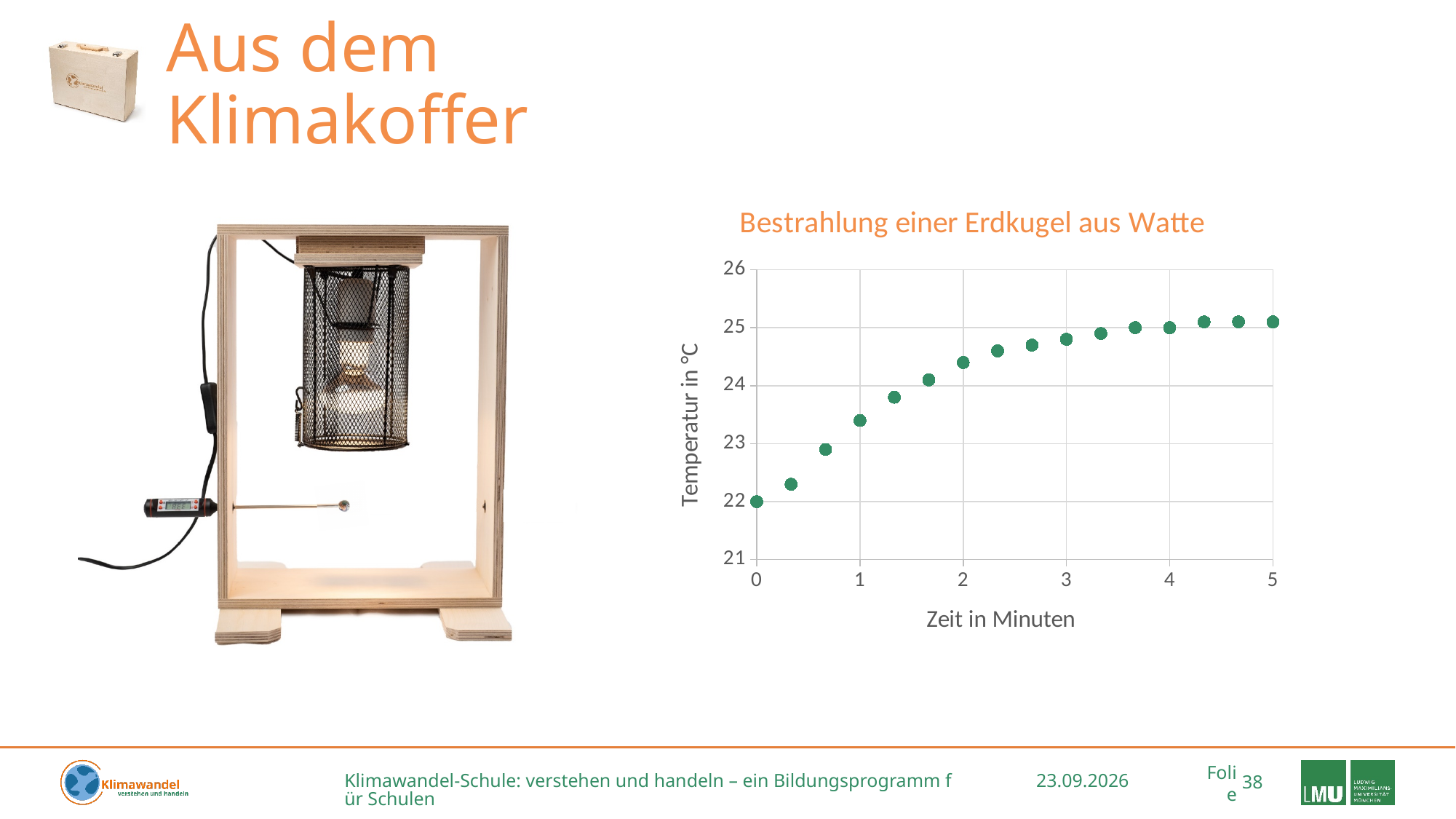
How many data points are plotted in the chart? 16 What kind of chart is shown on the slide? scatter chart What is the label of the y axis of the chart? Temperatur in °C Which is higher, the temperature at 1 minute or at 2 minutes? 2 minutes Is the temperature at 1 minute greater or less than 24? less Is the temperature at 1 minute greater or less than 23? greater At which time is the temperature lowest? 0 minutes Does the temperature rise or fall over time? rise Is the temperature at 3 minutes greater or less than 25? less What is the title of the chart? Bestrahlung einer Erdkugel aus Watte What is the temperature at 0 minutes? 22